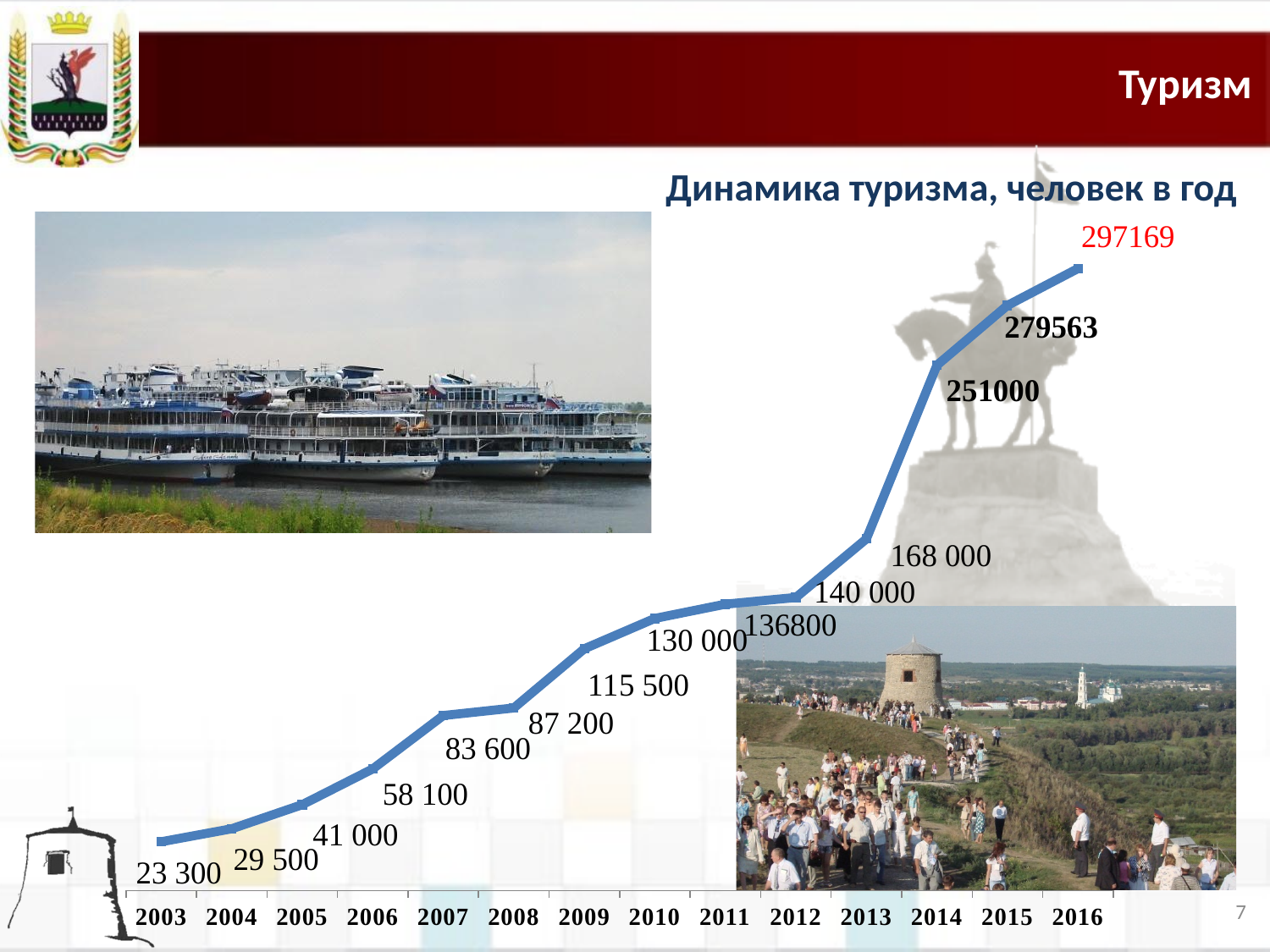
Which is larger, the value for 2007 or the value for 2008? 2008 How many years are plotted on the x axis? 14 What is the difference between the values for 2014 and 2013? 83 000 What is the difference between the values for 2016 and 2015? 17606 What is the value for 2014? 251000 Which year has the lowest value? 2003 What is the value for 2016? 297169 What is the value for 2009? 115 500 Which year has the highest value? 2016 What is the title of the chart? Динамика туризма, человек в год What kind of chart is shown on the slide? line chart What is the value for 2003? 23 300